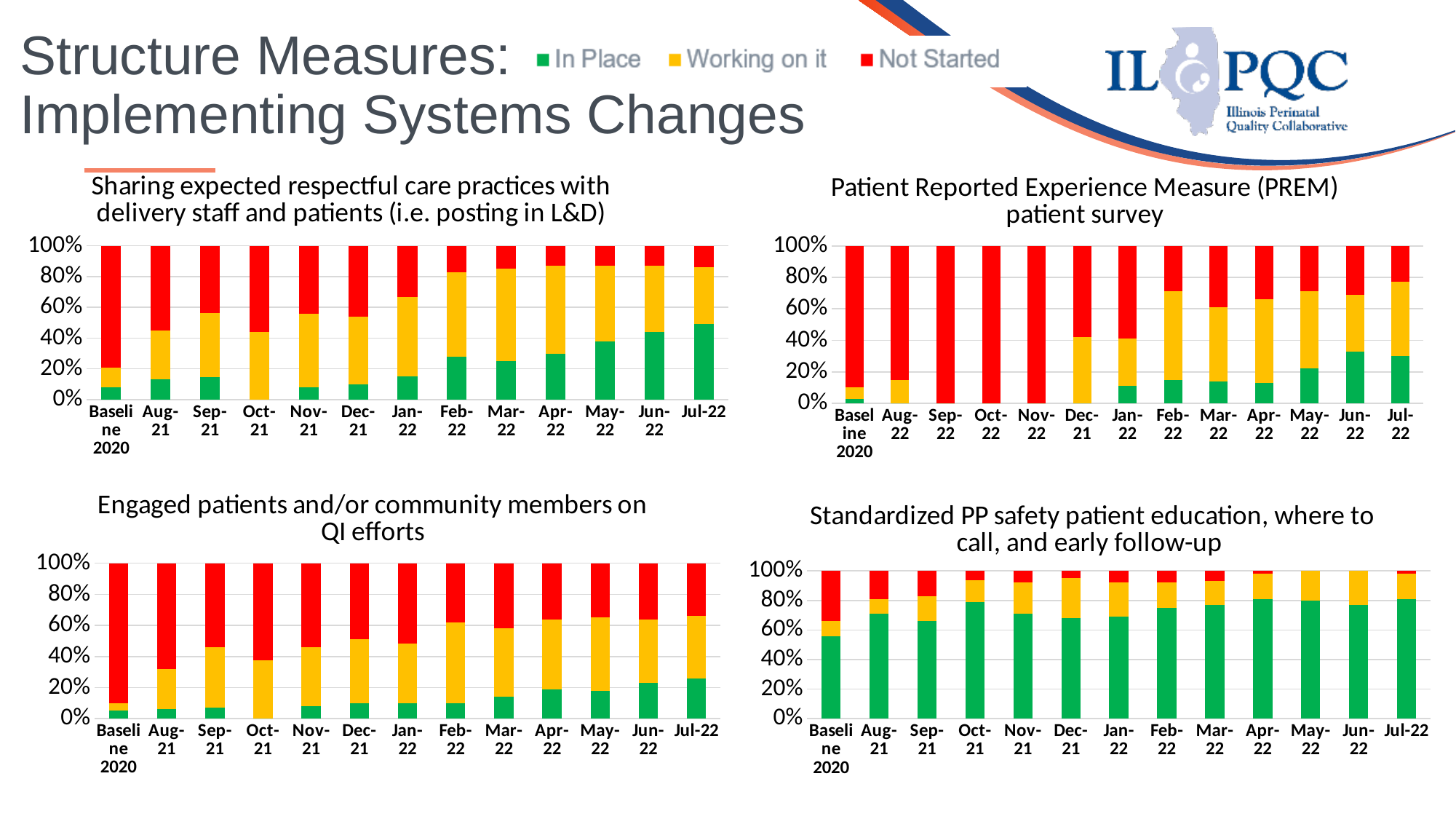
In the 'Engaged patients and/or community members on QI efforts' chart, does the 'In Place' share generally rise or fall from Baseline 2020 to Jul-22? rise How many categories are shown on the x axis of the 'Sharing expected respectful care practices with delivery staff and patients' chart? 13 In the 'Standardized PP safety patient education, where to call, and early follow-up' chart, is the 'In Place' value for Jul-22 greater or less than 60%? greater How many series does the legend at the top of the slide list? 3 Which colour represents 'Not Started' in the charts? red In the 'Standardized PP safety patient education, where to call, and early follow-up' chart, which category has the lowest 'In Place' share? Baseline 2020 What kind of chart is the 'Patient Reported Experience Measure (PREM) patient survey' chart? stacked bar chart In the 'Sharing expected respectful care practices with delivery staff and patients' chart, is the 'In Place' value for Baseline 2020 greater or less than 20%? less In the 'Patient Reported Experience Measure (PREM) patient survey' chart, is the 'In Place' value for Jul-22 greater or less than 40%? less In the 'Patient Reported Experience Measure (PREM) patient survey' chart, which months show 'Not Started' at 100%? Sep-22, Oct-22, Nov-22